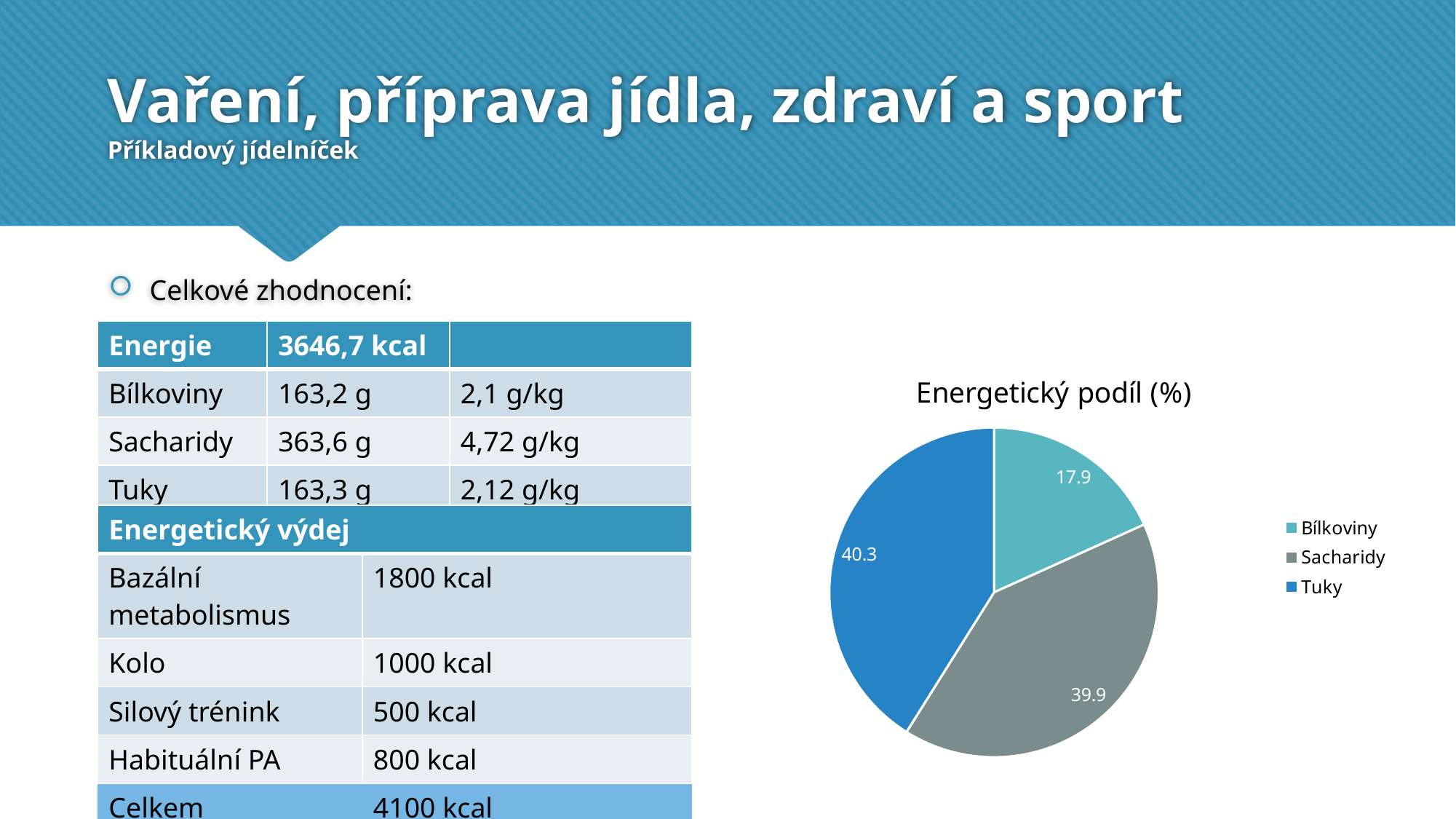
What is the value shown for Tuky in the pie chart? 40.3 What is the difference between the values for Sacharidy and Bílkoviny in the pie chart? 22.0 What is the title of the chart on the slide? Energetický podíl (%) How many entries does the legend of the pie chart list? 3 What is the difference between the values for Tuky and Bílkoviny in the pie chart? 22.4 What type of chart is shown on the slide? Pie chart What is the value shown for Sacharidy in the pie chart? 39.9 How many slices does the pie chart have? 3 What is the value shown for Bílkoviny in the pie chart? 17.9 Which is larger in the pie chart, the value for Sacharidy or the value for Bílkoviny? Sacharidy Which category has the largest slice in the pie chart, according to the data labels? Tuky Which category has the smallest slice in the pie chart? Bílkoviny